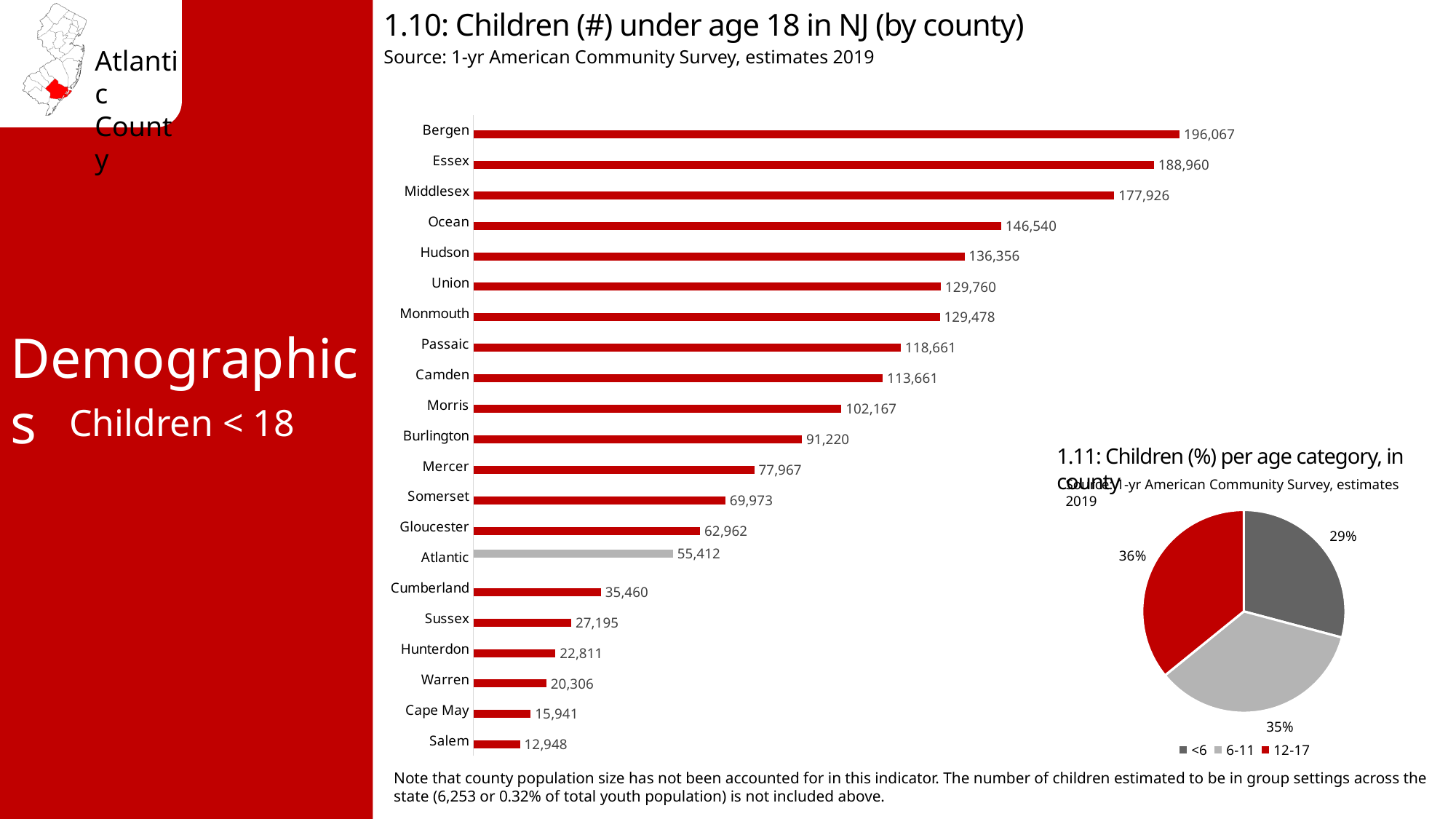
What kind of chart is '1.10: Children (#) under age 18 in NJ (by county)'? Bar chart In the chart '1.10: Children (#) under age 18 in NJ (by county)', what is the value for Ocean? 146,540 In the chart '1.10: Children (#) under age 18 in NJ (by county)', which county has the highest value? Bergen In the pie chart '1.11: Children (%) per age category, in county', what share is the 6-11 age category? 35% How many counties are shown in the chart '1.10: Children (#) under age 18 in NJ (by county)'? 21 In the pie chart '1.11: Children (%) per age category, in county', which age category has the largest share? 12-17 How many age categories does the legend of the pie chart '1.11: Children (%) per age category, in county' list? 3 In the chart '1.10: Children (#) under age 18 in NJ (by county)', what is the difference between the values for Bergen and Essex? 7,107 In the chart '1.10: Children (#) under age 18 in NJ (by county)', what is the value for Atlantic? 55,412 In the chart '1.10: Children (#) under age 18 in NJ (by county)', which county has the lowest value? Salem In the chart '1.10: Children (#) under age 18 in NJ (by county)', which is larger, the value for Gloucester or the value for Cumberland? Gloucester In the chart '1.10: Children (#) under age 18 in NJ (by county)', which county's bar is shown in grey instead of red? Atlantic